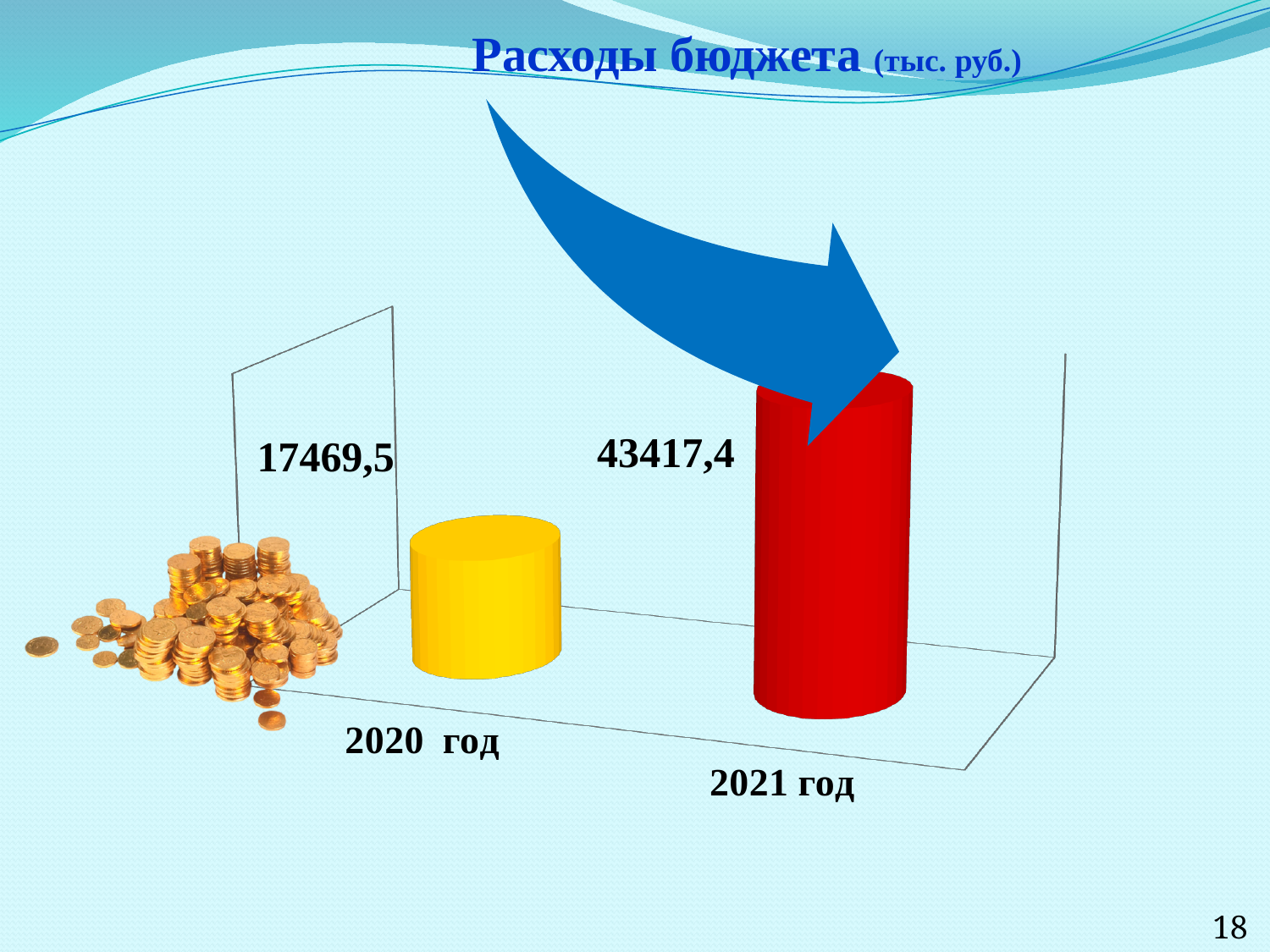
Which is larger, the value for 2020 год or the value for 2021 год? 2021 год Do the values rise or fall from 2020 год to 2021 год? rise What is the difference between the values for 2021 год and 2020 год? 25947,9 What is the value for 2021 год? 43417,4 How many categories are shown in the chart? 2 What colour is the bar for 2021 год? red Which year has the lowest budget expenditure? 2020 год What kind of chart is shown on the slide? bar chart Which year has the highest budget expenditure? 2021 год What is the value for 2020 год? 17469,5 What is the title of the chart? Расходы бюджета (тыс. руб.) What unit is given in the chart title? тыс. руб.